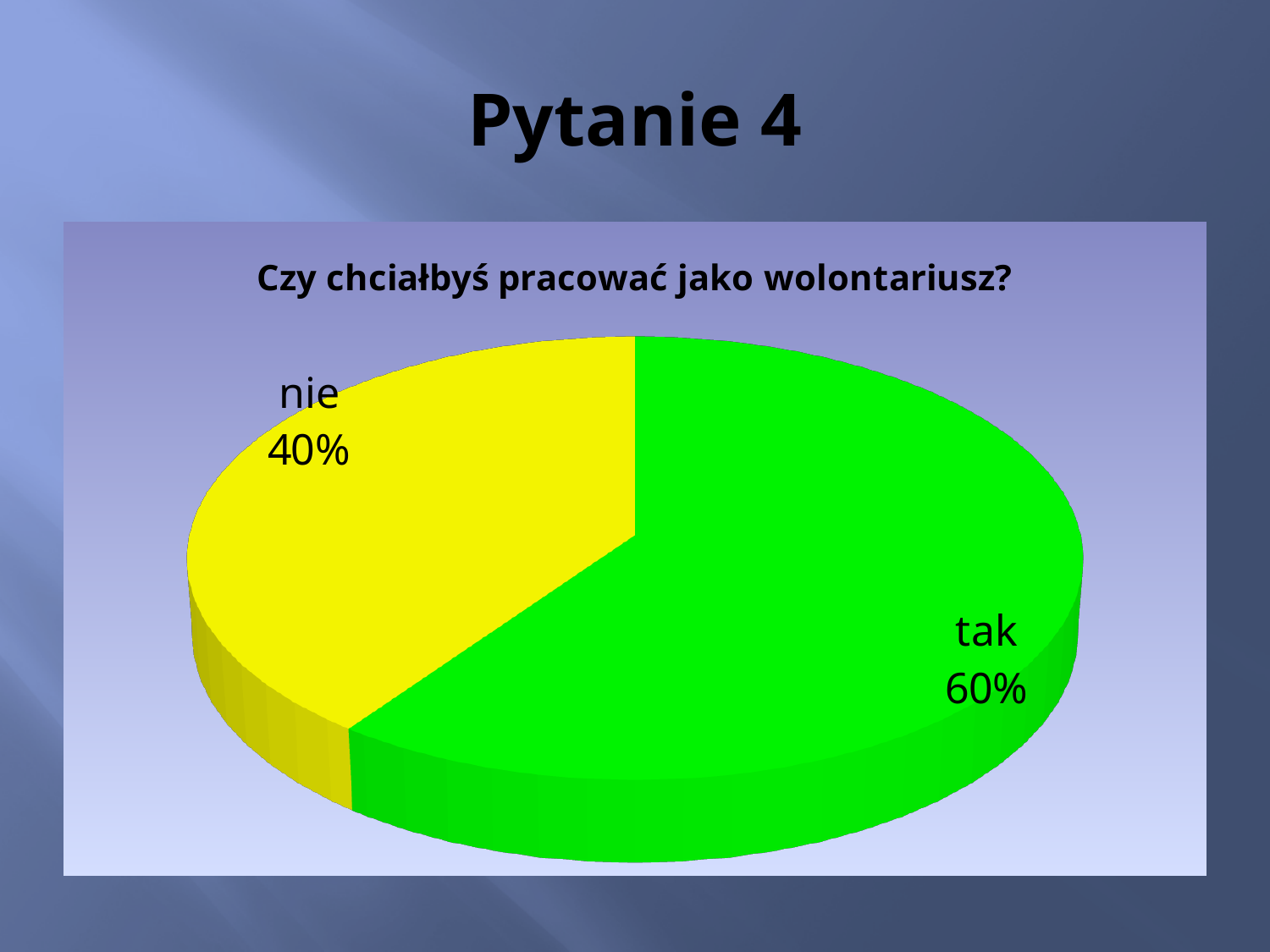
What share of the pie does the "tak" slice represent? 60% How many slices does the pie chart have? 2 What is the title of the chart? Czy chciałbyś pracować jako wolontariusz? Which is larger, the "tak" slice or the "nie" slice? tak Which slice is the largest in the pie chart? tak What share of the pie does the "nie" slice represent? 40% What colour is the "tak" slice? green Which slice is the smallest in the pie chart? nie Is the share for "nie" greater or less than 50%? less What is the difference in percentage points between the "tak" and "nie" slices? 20 percentage points What kind of chart is shown on the slide? pie chart